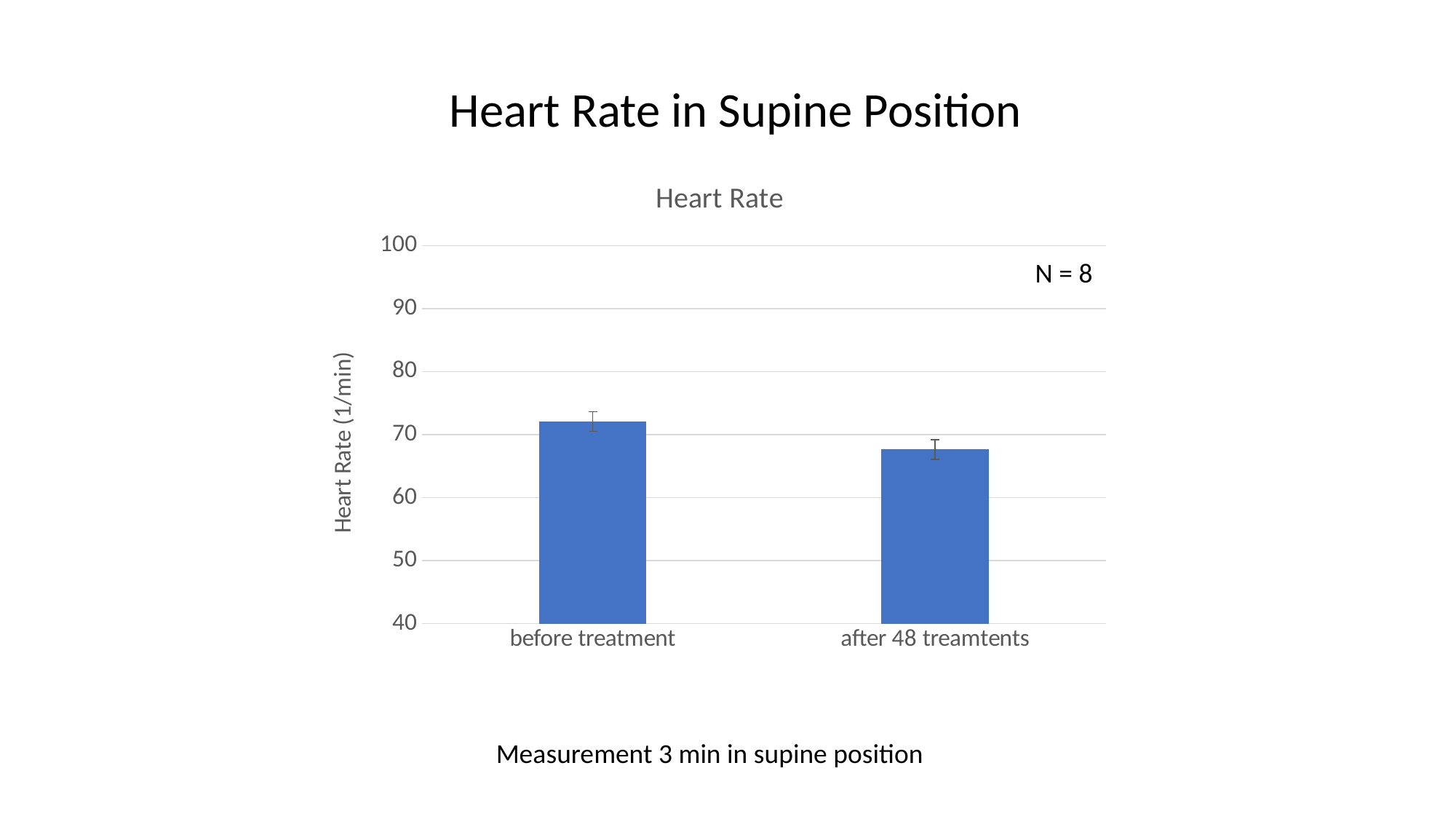
What kind of chart is shown on the slide? bar chart Does the heart rate rise or fall from before treatment to after 48 treamtents? fall Is the value for before treatment greater or less than 70? greater Which is larger, the value for before treatment or the value for after 48 treamtents? before treatment Is the value for after 48 treamtents greater or less than 60? greater Is the value for before treatment greater or less than 80? less How many categories are plotted on the x axis? 2 Which category has the higher heart rate? before treatment What is the label of the y axis? Heart Rate (1/min) Which category has the lower heart rate? after 48 treamtents What is the title of the chart? Heart Rate